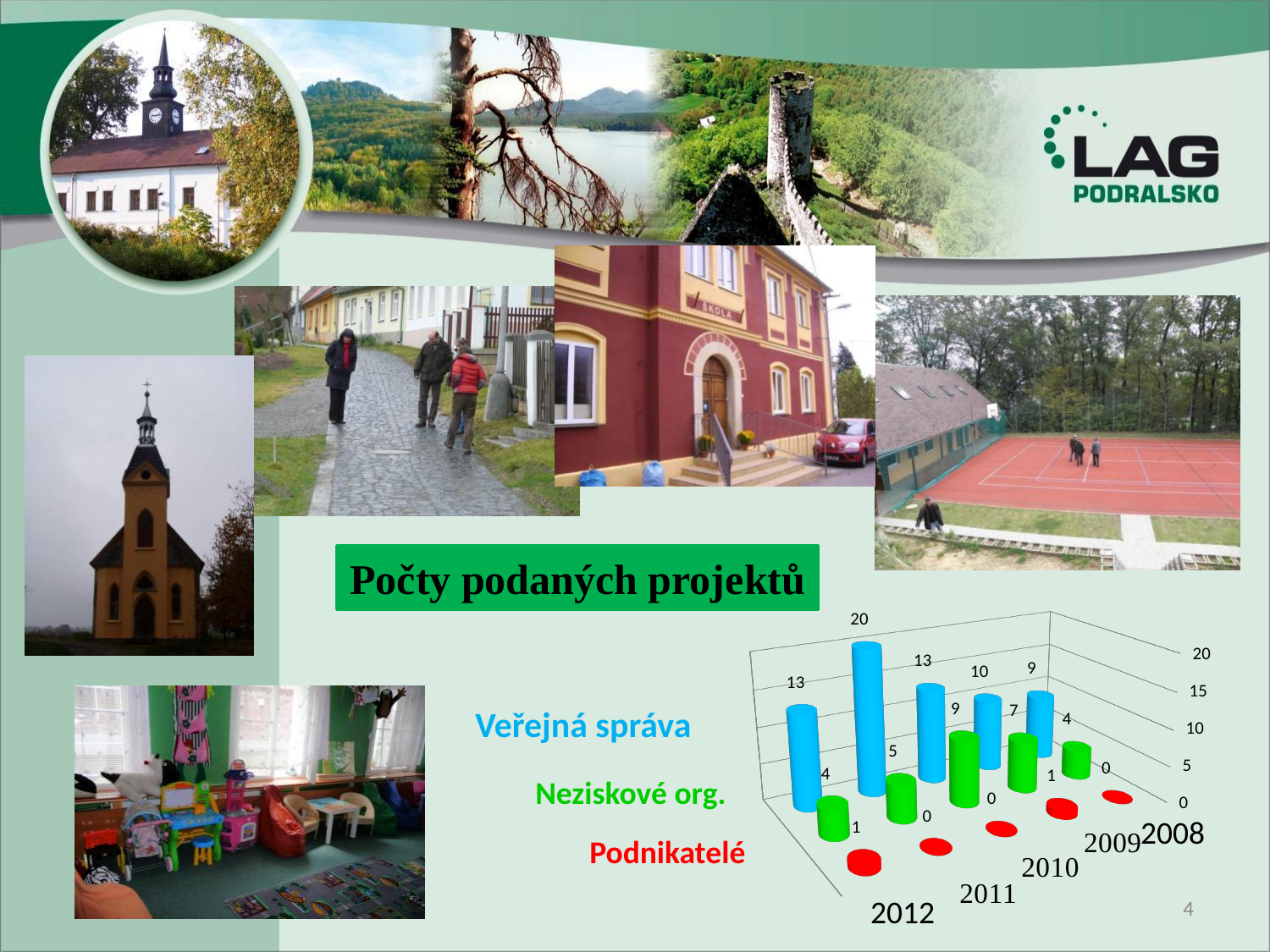
What is the value for Neziskové org. in 2010? 9 How many series does the chart show? 3 In which year is the value for Neziskové org. highest? 2010 Which colour represents the Podnikatelé series in the chart? red What is the value for Veřejná správa in 2008? 9 What is the value for Veřejná správa in 2011? 20 How many years are shown along the x axis of the chart? 5 What is the title of the chart on the slide? Počty podaných projektů What kind of chart is shown on the slide? bar chart In which year is the value for Veřejná správa highest? 2011 Which is larger, the Veřejná správa value for 2009 or the Neziskové org. value for 2009? Veřejná správa What is the difference between the Veřejná správa values for 2011 and 2012? 7